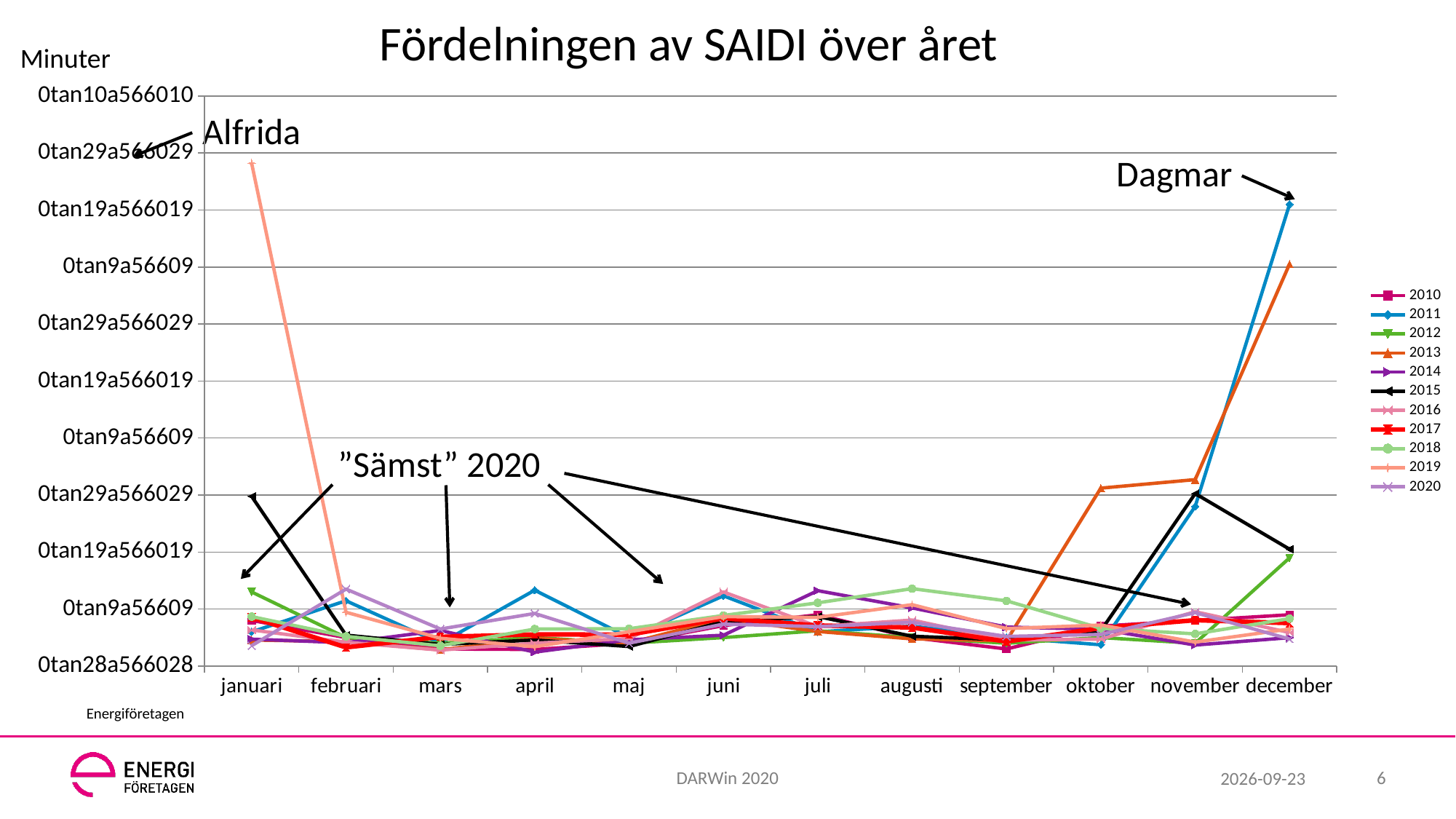
Does the 2013 series rise or fall from oktober to december? rise What is the title of the chart? Fördelningen av SAIDI över året In december, which is larger: the value for 2011 or the value for 2013? 2011 In which month does the 2011 series reach its highest value? december How many months are shown along the x axis? 12 Which series has the highest value in december? 2011 How many series does the legend list? 11 What kind of chart is shown on the slide? line chart In which month does the 2019 series reach its highest value? januari In januari, which is larger: the value for 2019 or the value for 2015? 2019 In oktober, which is larger: the value for 2013 or the value for 2011? 2013